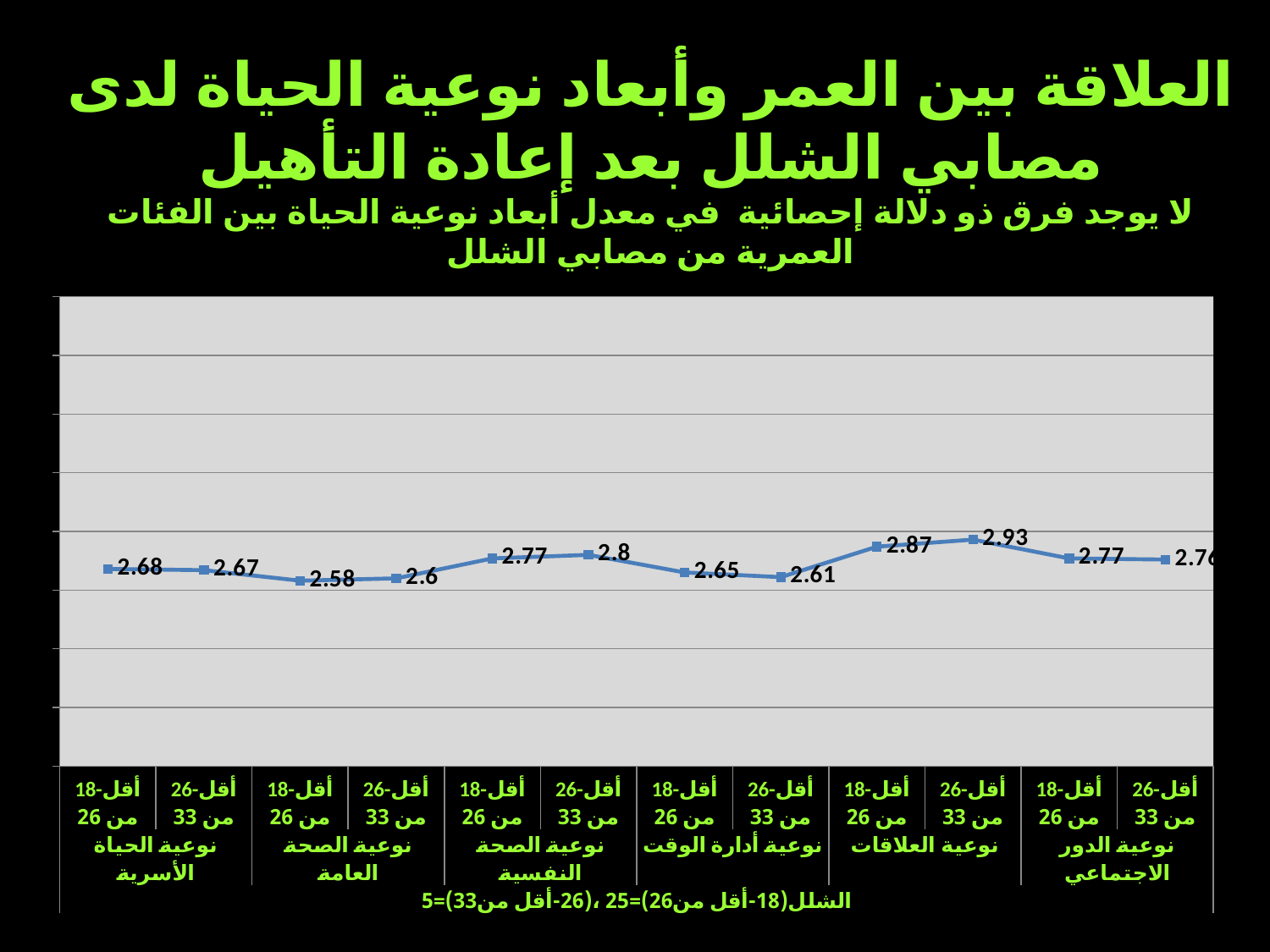
What is the difference between the 26-أقل من 33 value under نوعية العلاقات and the 18-أقل من 26 value under نوعية الصحة العامة? 0.35 How many quality-of-life dimensions are shown along the x axis? 6 What is the value for the 18-أقل من 26 age group under نوعية العلاقات? 2.87 What is the value for the 18-أقل من 26 age group under نوعية الحياة الأسرية? 2.68 How many data points are plotted on the line? 12 Which data point has the highest value on the chart? 26-أقل من 33 under نوعية العلاقات (2.93) Which data point has the lowest value on the chart? 18-أقل من 26 under نوعية الصحة العامة (2.58) What is the value for the 26-أقل من 33 age group under نوعية الصحة النفسية? 2.8 What is the value for the 18-أقل من 26 age group under نوعية أدارة الوقت? 2.65 Which is larger: the 18-أقل من 26 value under نوعية الصحة النفسية or the 18-أقل من 26 value under نوعية أدارة الوقت? نوعية الصحة النفسية (2.77) What is the value for the 26-أقل من 33 age group under نوعية الصحة العامة? 2.6 What kind of chart is shown on the slide? line chart